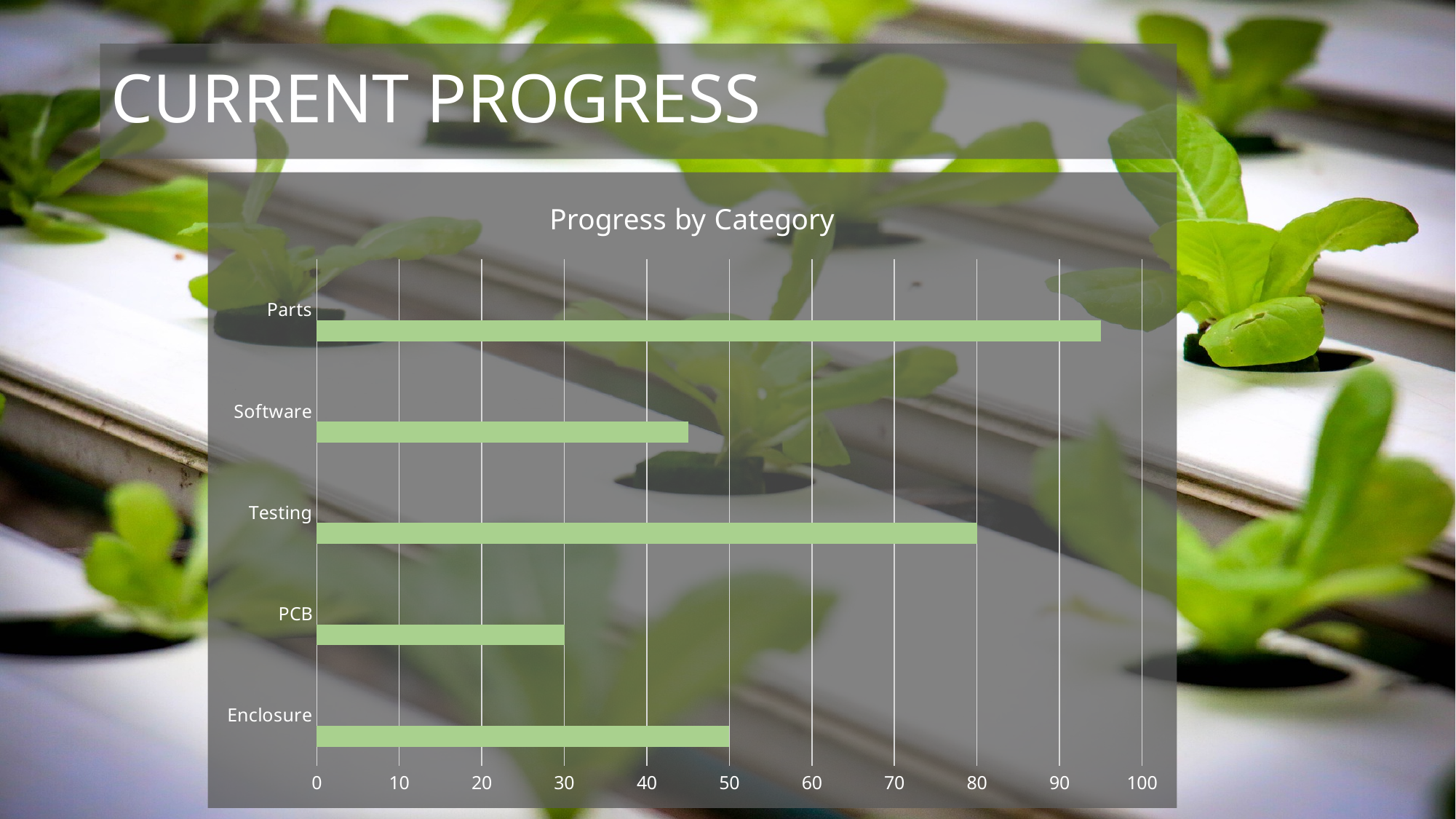
Which category has the highest value? Parts What is the difference between the values for Testing and PCB? 50 Is the value for Parts greater or less than 90? greater What type of chart is shown on the slide? Bar chart What is the value for PCB? 30 How many categories are shown in the chart? 5 Which is larger, the value for Testing or the value for Software? Testing What is the value for Enclosure? 50 Which category has the lowest value? PCB Is the value for Software greater or less than 50? less What is the title of the chart? Progress by Category What is the value for Testing? 80